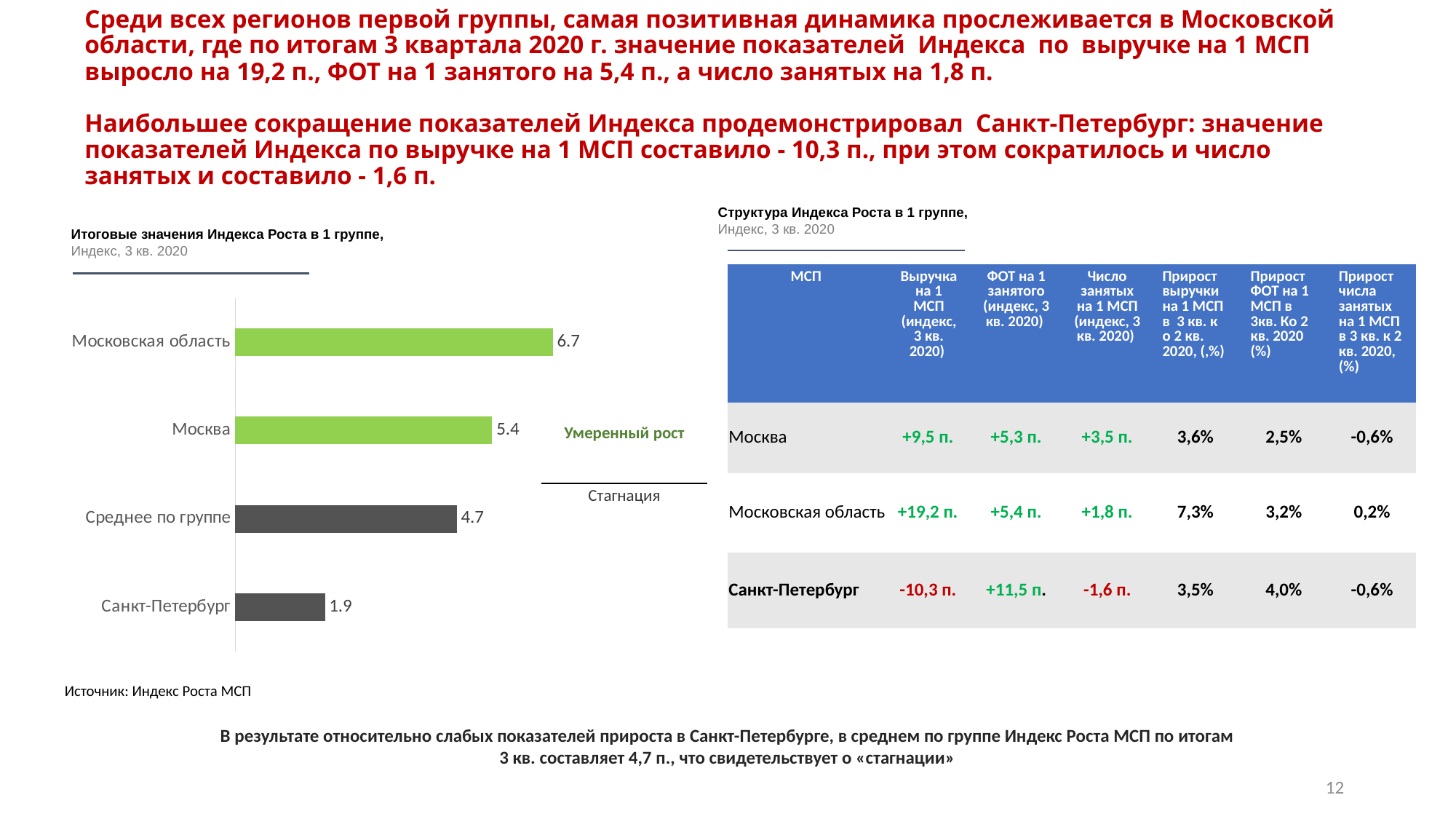
What is the difference between the values for Московская область and Санкт-Петербург in the bar chart? 4.8 What is the title of the bar chart? Итоговые значения Индекса Роста в 1 группе What is the value for Среднее по группе in the bar chart? 4.7 What is the value for Москва in the bar chart? 5.4 What is the value for Московская область in the bar chart? 6.7 Which is larger in the bar chart: the value for Москва or the value for Санкт-Петербург? Москва How many categories are shown in the bar chart? 4 What is the difference between the values for Москва and Среднее по группе in the bar chart? 0.7 Which category has the highest value in the bar chart? Московская область What type of chart is shown on the slide? bar chart What is the value for Санкт-Петербург in the bar chart? 1.9 Which category has the lowest value in the bar chart? Санкт-Петербург